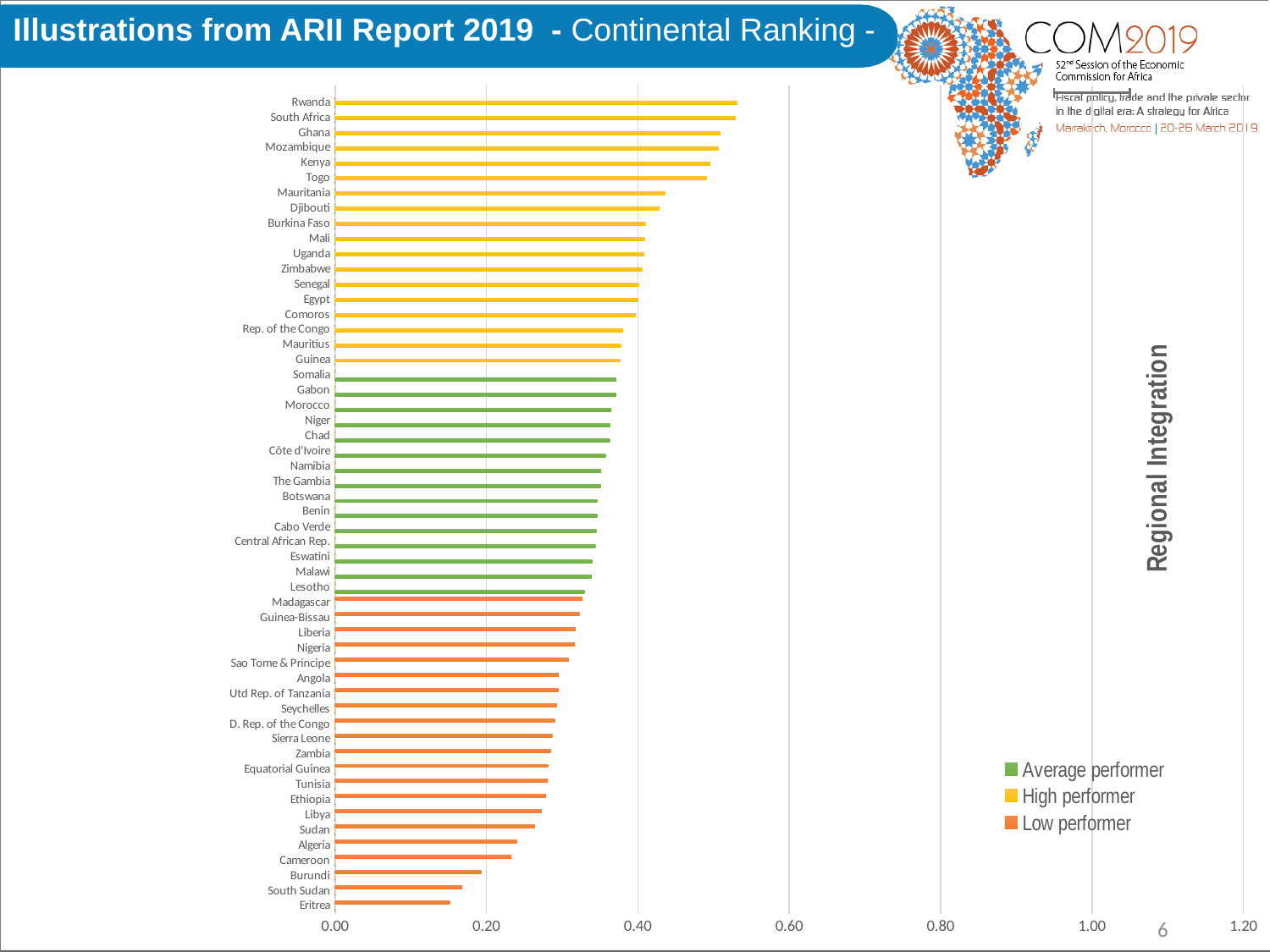
Is the value for Eritrea greater or less than 0.20? less How many countries are plotted in the chart? 54 Which country has the lowest Regional Integration score? Eritrea Which has the larger value, Togo or Somalia? Togo What kind of chart is shown on the slide? Bar chart Is the value for Kenya greater or less than 0.40? greater Which colour does the legend use for High performer? Yellow Is the value for Algeria greater or less than 0.40? less How many series does the legend list? 3 Which has the larger value, Ghana or Algeria? Ghana Which country has the highest Regional Integration score? Rwanda